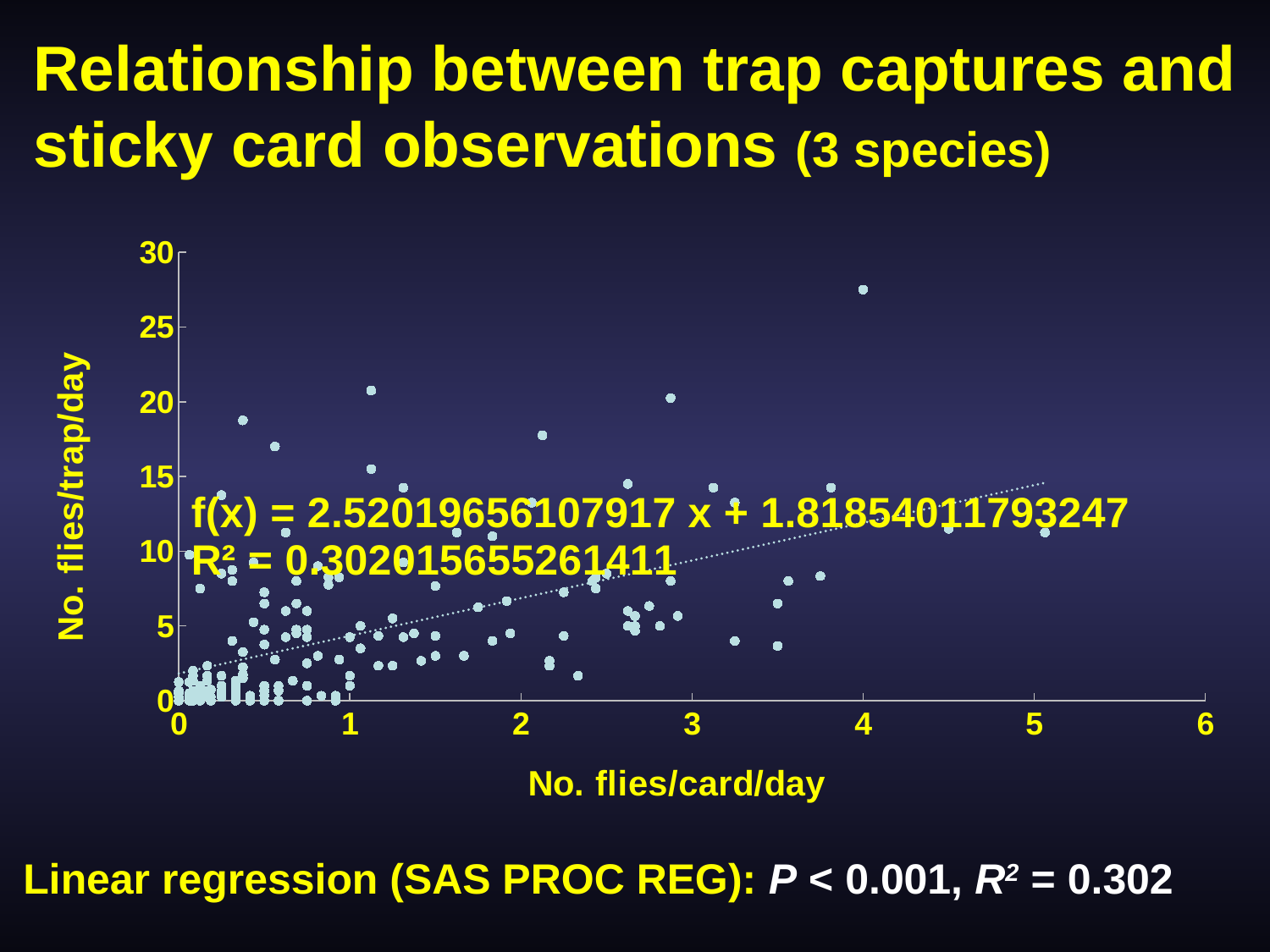
What is the title of the x axis? No. flies/card/day What is the intercept of the fitted line f(x) shown on the chart? 1.81854011793247 What is the title of the y axis? No. flies/trap/day What is the maximum value shown on the y axis? 30 Is the value of the fitted line at x = 5 greater or less than 10 flies/trap/day? greater Does the fitted trendline rise or fall as No. flies/card/day increases? Rises What is the maximum value shown on the x axis? 6 What R² value is reported in the text below the chart? 0.302 What kind of chart is shown on the slide? Scatter chart What R² value is printed on the chart? 0.302015655261411 Is the highest plotted point (at about 4 flies/card/day) greater or less than 25 flies/trap/day? greater What is the slope of the fitted line f(x) shown on the chart? 2.52019656107917